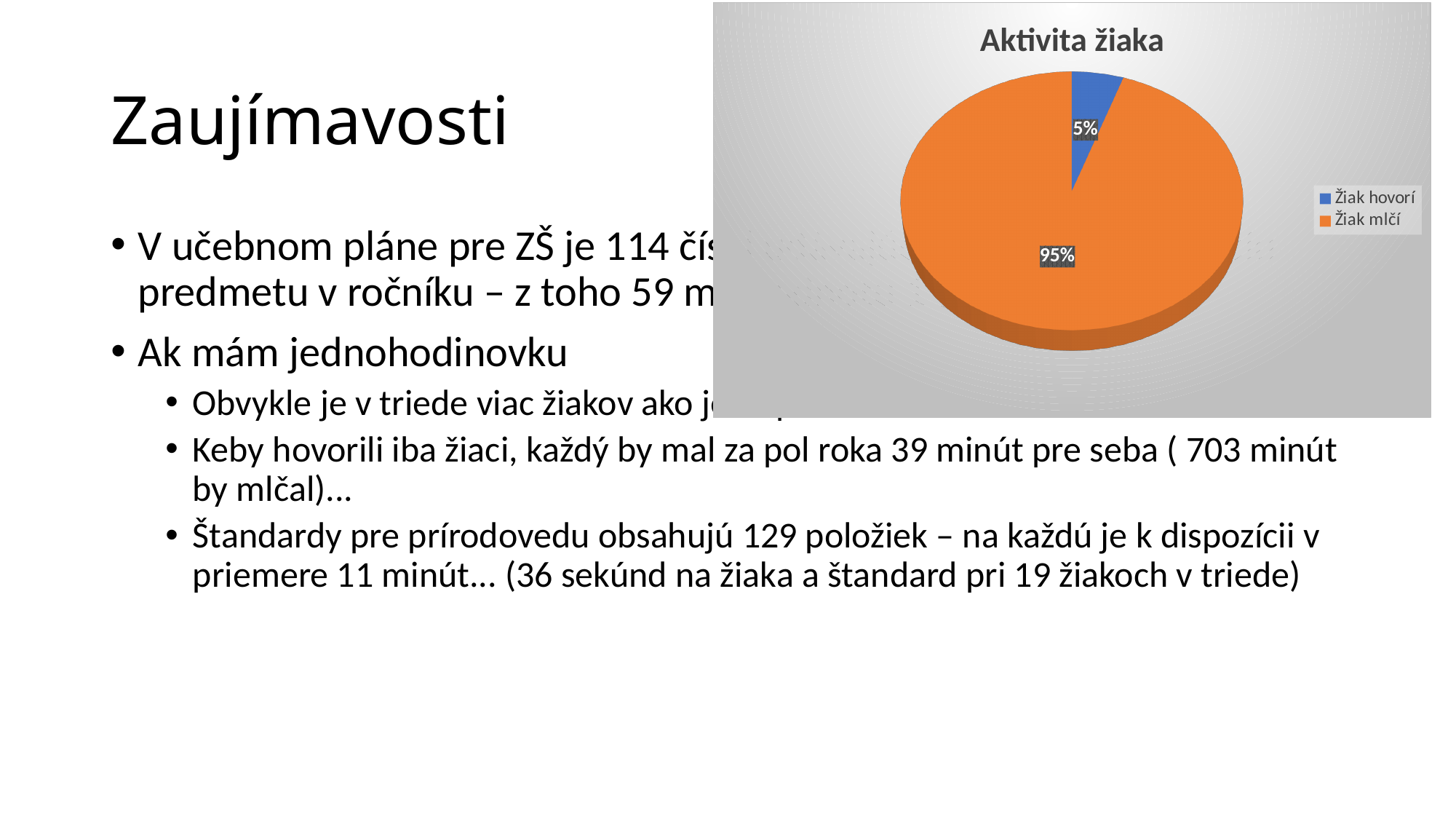
Which is larger, the slice for "Žiak hovorí" or the slice for "Žiak mlčí"? Žiak mlčí Which category has the smallest slice of the pie? Žiak hovorí What share of the pie does "Žiak hovorí" represent? 5% What is the difference in percentage points between "Žiak mlčí" and "Žiak hovorí"? 90 What colour is the slice for "Žiak hovorí"? blue What share of the pie does "Žiak mlčí" represent? 95% How many entries does the legend list? 2 Which category has the largest slice of the pie? Žiak mlčí What is the title of the chart? Aktivita žiaka How many categories does the pie chart show? 2 What kind of chart is shown on the slide? pie chart